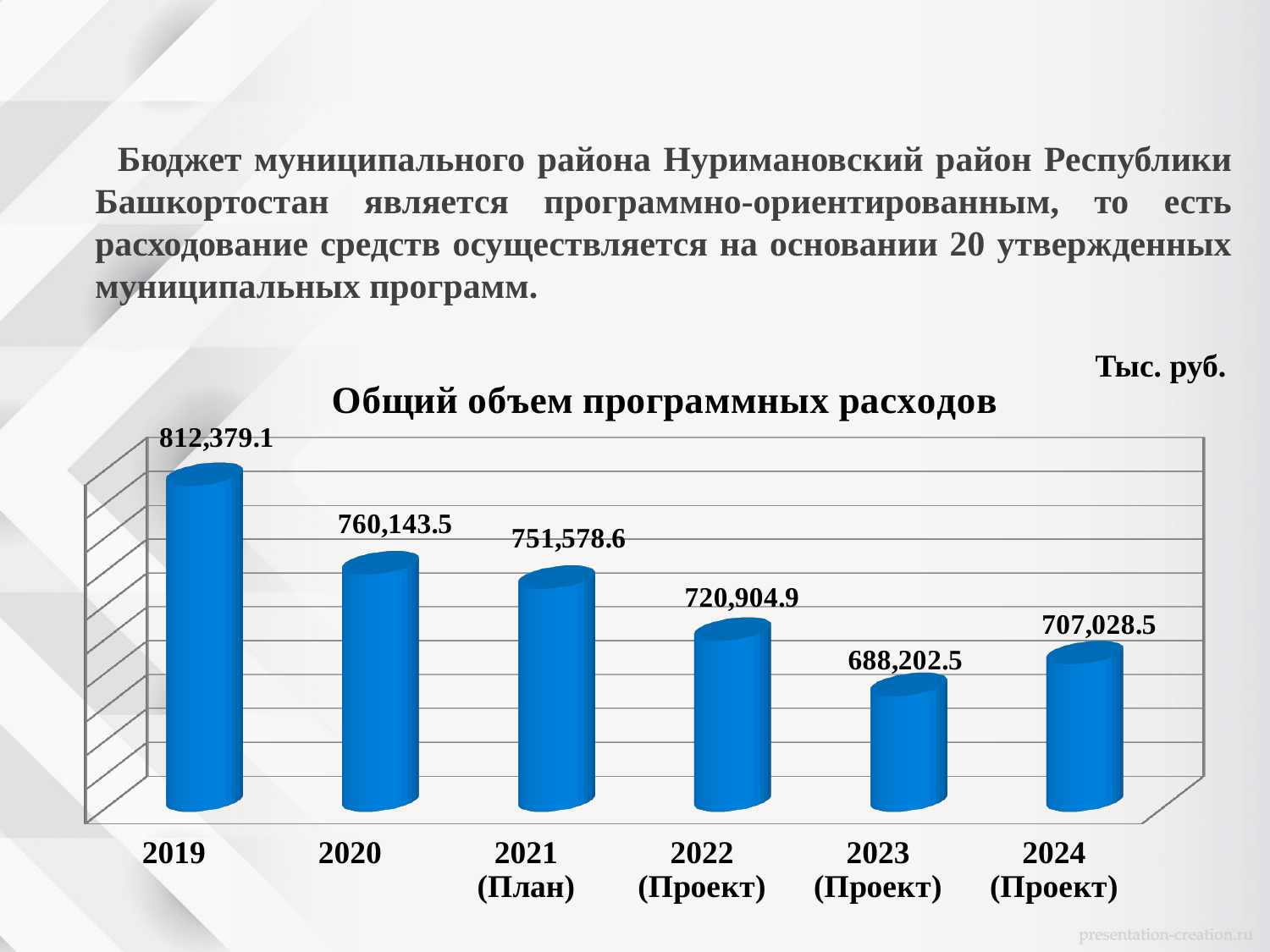
What is the difference between the values for 2019 and 2020? 52,235.6 What is the value for 2019 in the chart? 812,379.1 Which year has the highest value in the chart? 2019 Which is larger, the value for 2021 (План) or the value for 2022 (Проект)? 2021 (План) Do the values rise or fall from 2019 to 2023? Fall Which year has the lowest value in the chart? 2023 (Проект) What kind of chart is shown on the slide? Bar chart What is the difference between the values for 2024 (Проект) and 2023 (Проект)? 18,826.0 What is the title of the chart? Общий объем программных расходов How many years (categories) are shown in the chart? 6 What is the value for 2022 (Проект)? 720,904.9 What is the value for 2024 (Проект)? 707,028.5